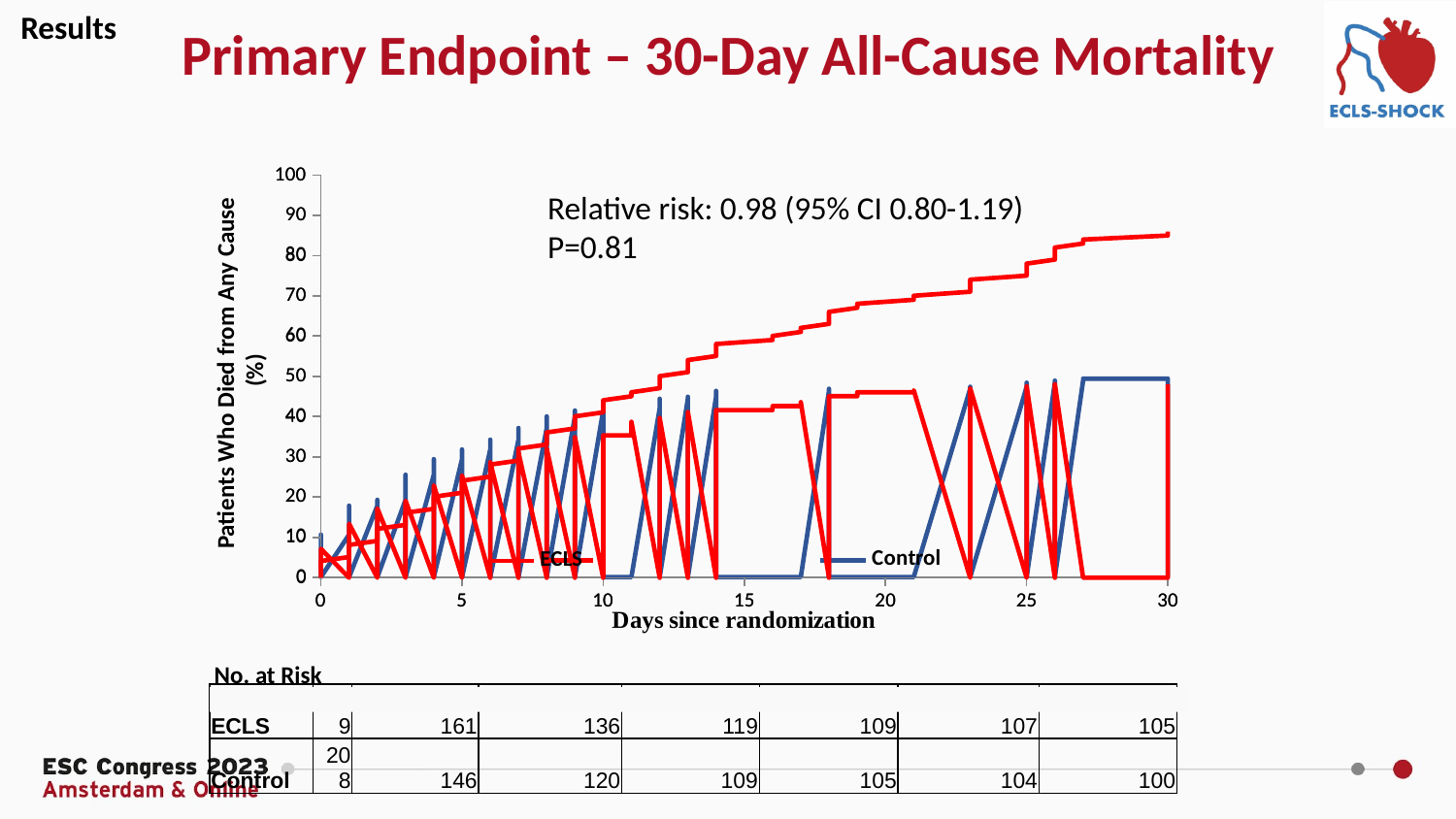
What relative risk is printed on the chart? 0.98 (95% CI 0.80-1.19) In the No. at Risk table below the chart, what is the last number shown in the ECLS row? 105 At day 5, is the ECLS line greater or less than 30%? less What are the two series named in the chart's legend? ECLS and Control Does the ECLS line rise or fall as days since randomization increase? rise What kind of chart is shown on the slide? line chart How many series does the chart's legend list? 2 What is the highest value shown on the x axis of the chart? 30